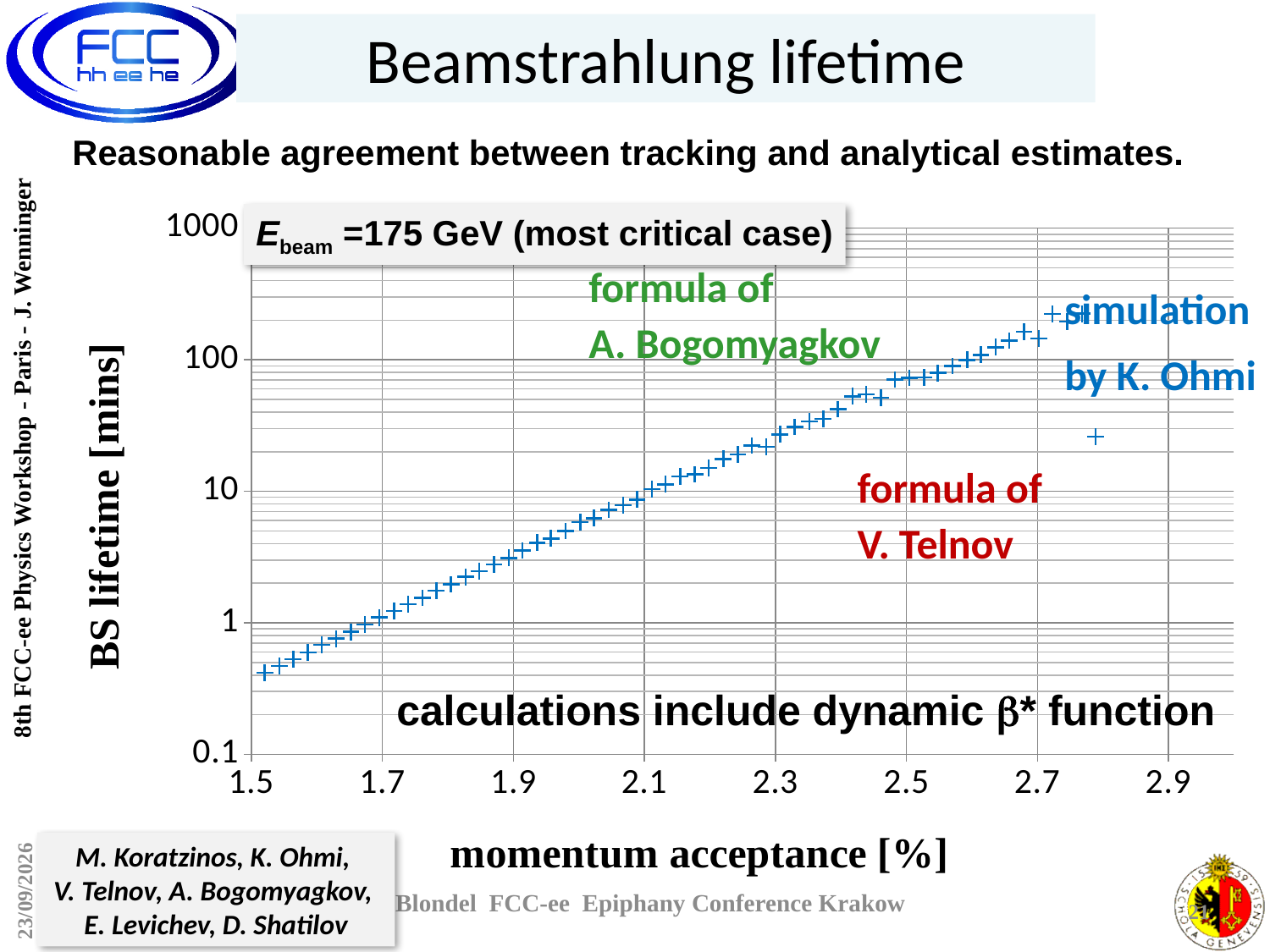
What is the label of the y axis? BS lifetime [mins] What is the label of the x axis? momentum acceptance [%] Which of the two values is larger: the BS lifetime at 2.1% momentum acceptance or at 2.7% momentum acceptance? 2.7% Is the BS lifetime at a momentum acceptance of 2.3% greater or less than 10 mins? greater Is the BS lifetime at a momentum acceptance of 2.5% greater or less than 100 mins? less Is the BS lifetime at a momentum acceptance of 1.9% greater or less than 1 min? greater Do the plotted BS lifetime values rise or fall as momentum acceptance increases along the x axis? rise What is the highest tick value shown on the y axis? 1000 What kind of chart is shown on the slide? scatter plot